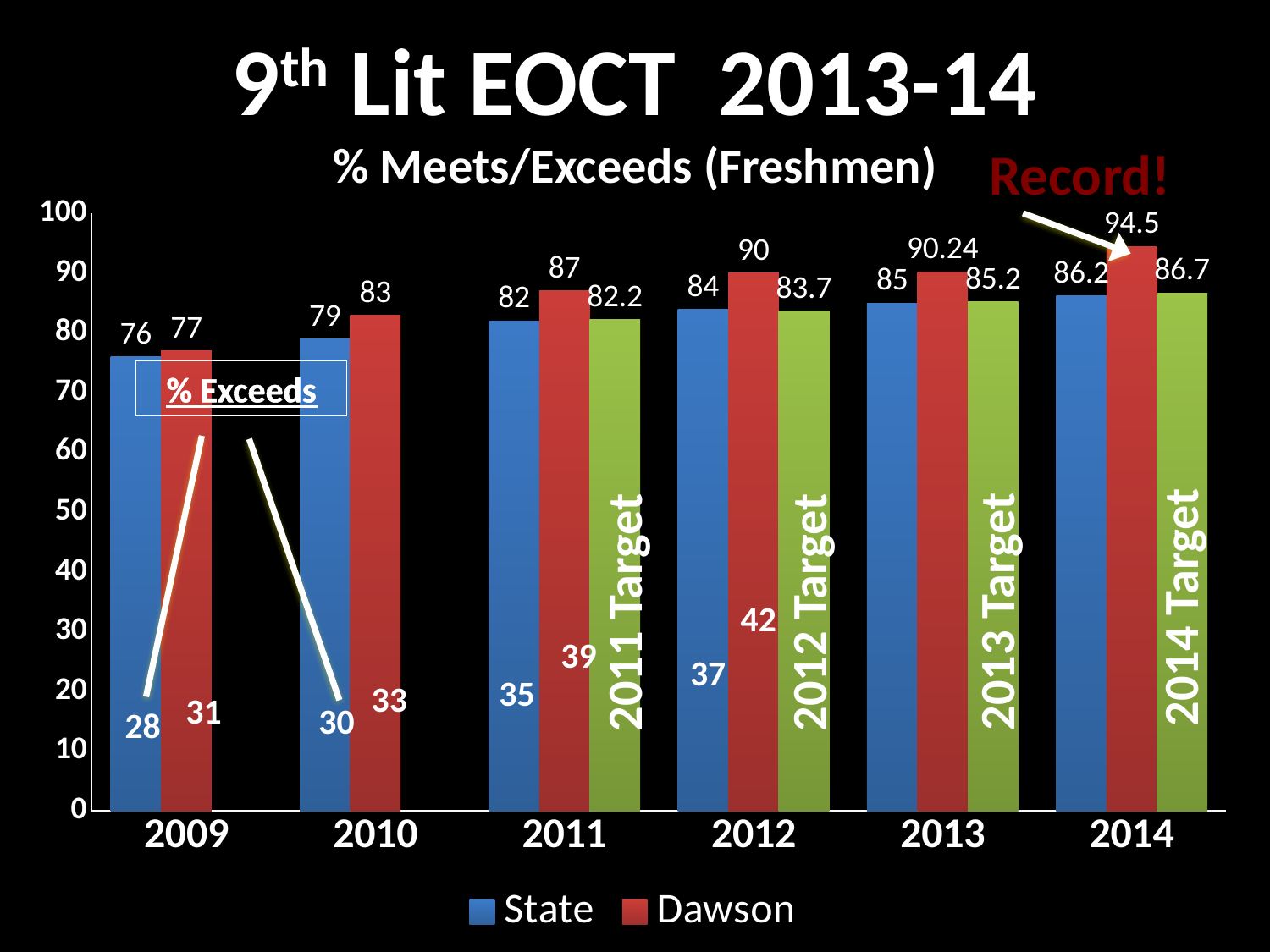
What is the State value for 2011? 82 Do the State values rise or fall from 2009 to 2014? Rise How many series does the legend list? 2 What kind of chart is shown on the slide? Bar chart Which is larger in 2010, the State value or the Dawson value? Dawson What is the Dawson value for 2014? 94.5 What is the 2013 Target value shown on the green bar? 85.2 What is the Dawson value for 2013? 90.24 What is the difference between the Dawson and State values in 2012? 6 In which year is the Dawson value highest? 2014 In which year is the State value lowest? 2009 How many years are shown on the x axis? 6